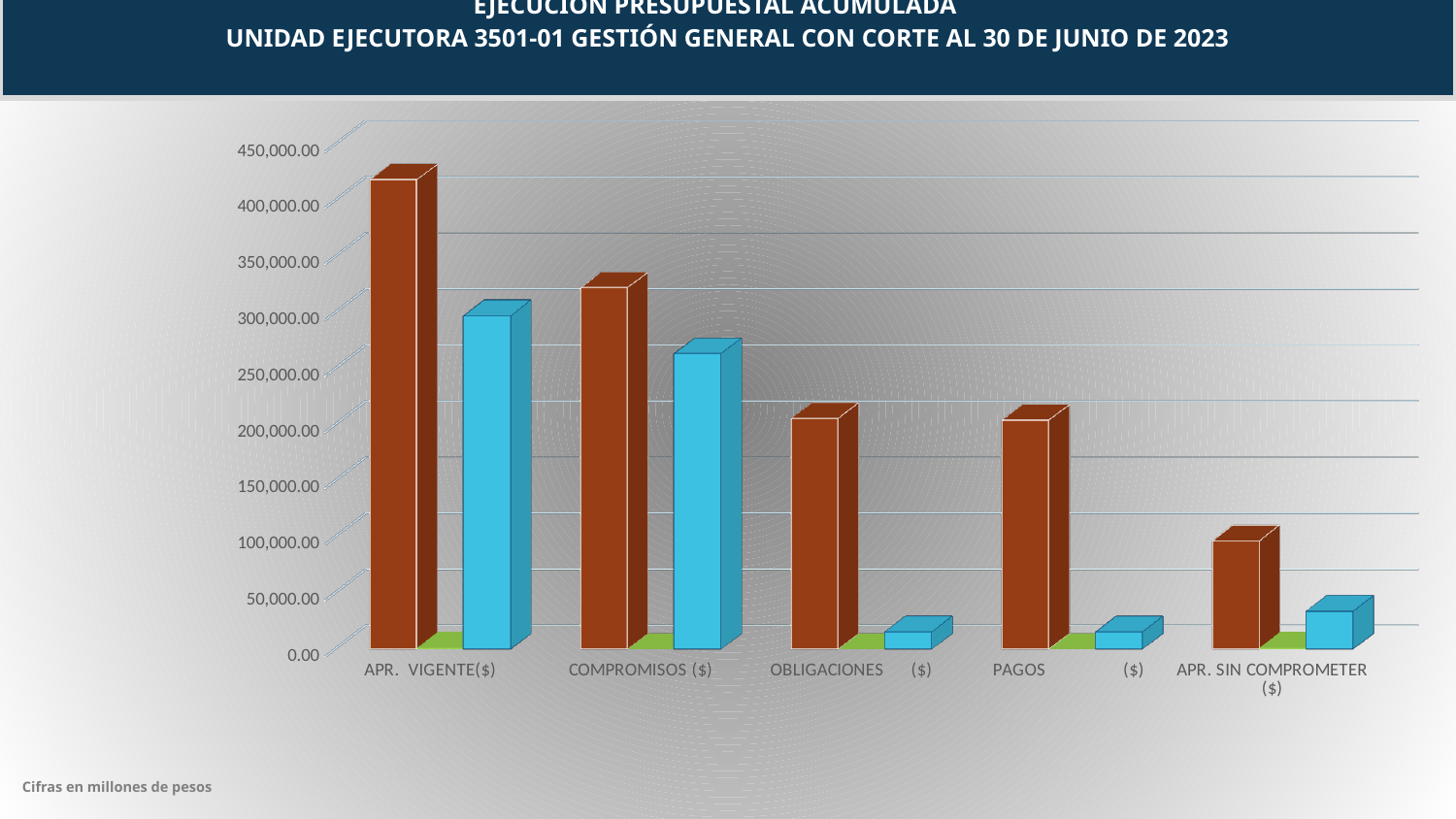
Do the brown bars generally rise or fall from left to right along the x axis? fall According to the note at the bottom of the slide, in what units are the figures expressed? millones de pesos Which category has the shortest brown bar? APR. SIN COMPROMETER ($) Is the blue bar for COMPROMISOS ($) greater or less than 250,000.00? greater Is the brown bar for APR. SIN COMPROMETER ($) greater or less than 150,000.00? less Which is larger, the brown bar for APR. VIGENTE($) or the brown bar for COMPROMISOS ($)? APR. VIGENTE($) Is the brown bar for COMPROMISOS ($) greater or less than 350,000.00? less How many categories are shown along the x axis? 5 Which category has the tallest brown bar? APR. VIGENTE($) What kind of chart is shown on the slide? bar chart Which category has the tallest blue bar? APR. VIGENTE($)